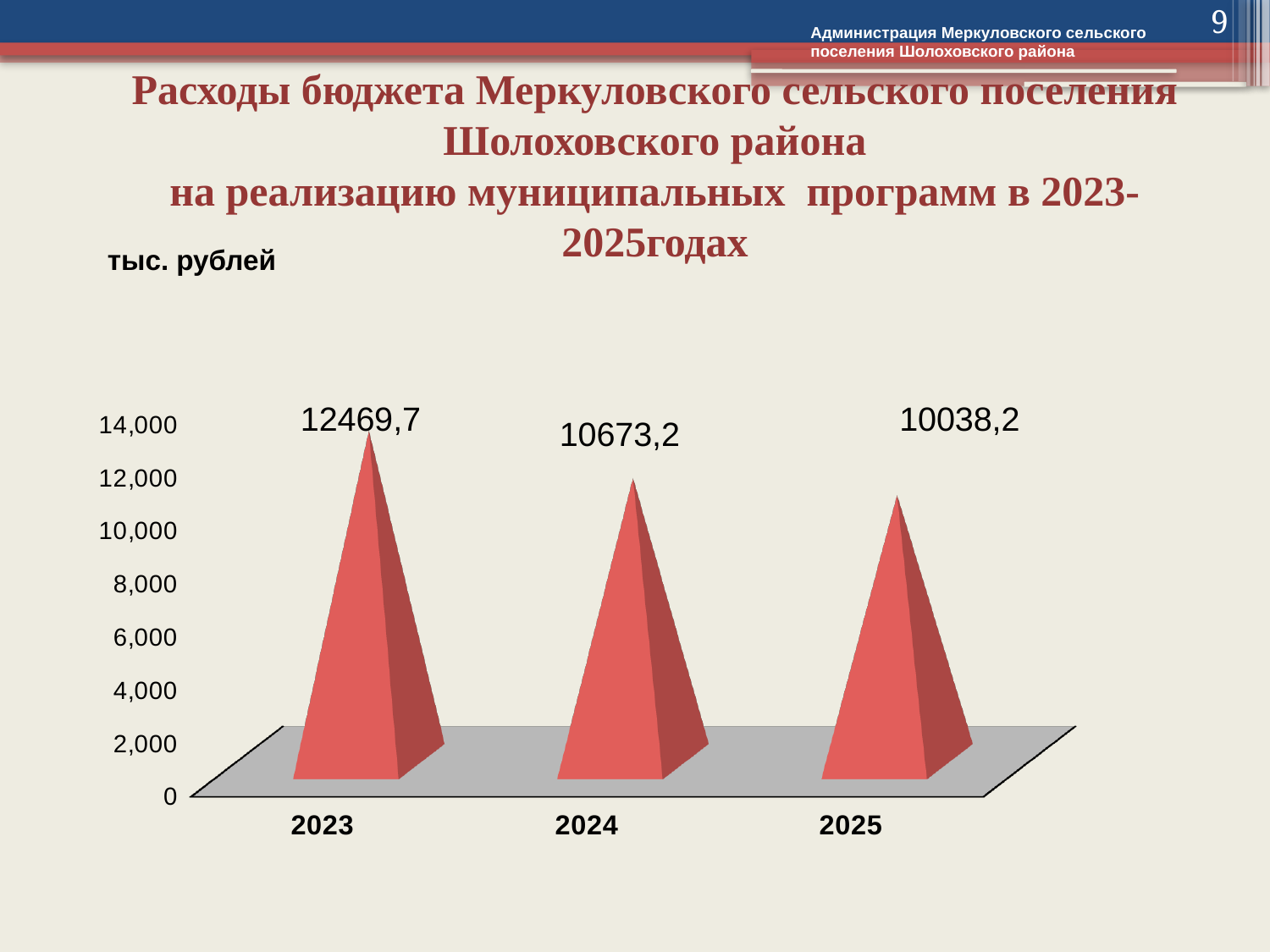
What is the value for 2023? 12469,7 What is the difference between the values for 2023 and 2024? 1796,5 How many years are shown on the x axis? 3 Is the value for 2023 greater or less than 12,000? greater What is the value for 2024? 10673,2 Which is larger, the value for 2023 or the value for 2025? 2023 What is the difference between the values for 2024 and 2025? 635 What is the value for 2025? 10038,2 Do the values rise or fall from 2023 to 2025? fall Which year has the highest value? 2023 Which year has the lowest value? 2025 What kind of chart is shown on the slide? bar chart